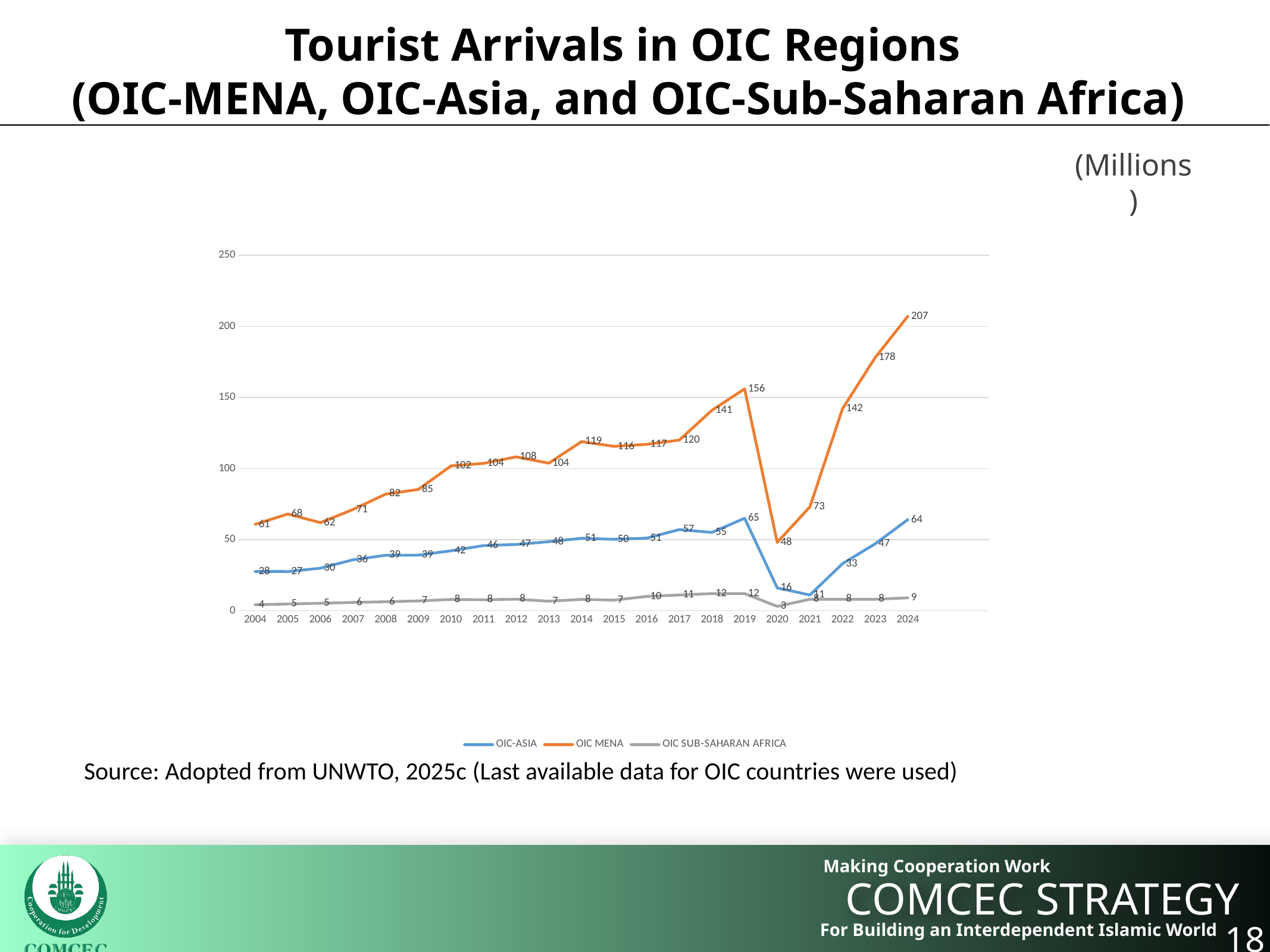
In which year did OIC-ASIA have its lowest value? 2021 How many series does the legend list? 3 What kind of chart is shown on the slide? Line chart What was the value for OIC MENA in 2024? 207 What was the value for OIC-ASIA in 2019? 65 What was the value for OIC SUB-SAHARAN AFRICA in 2020? 3 Which series had the higher value in 2020, OIC MENA or OIC-ASIA? OIC MENA Did the OIC MENA value rise or fall from 2019 to 2020? Fall What is the difference between the OIC MENA values in 2024 and 2023? 29 What is the difference between the OIC MENA and OIC-ASIA values in 2019? 91 In which year did OIC MENA reach its highest value? 2024 How many years are shown on the x axis? 21